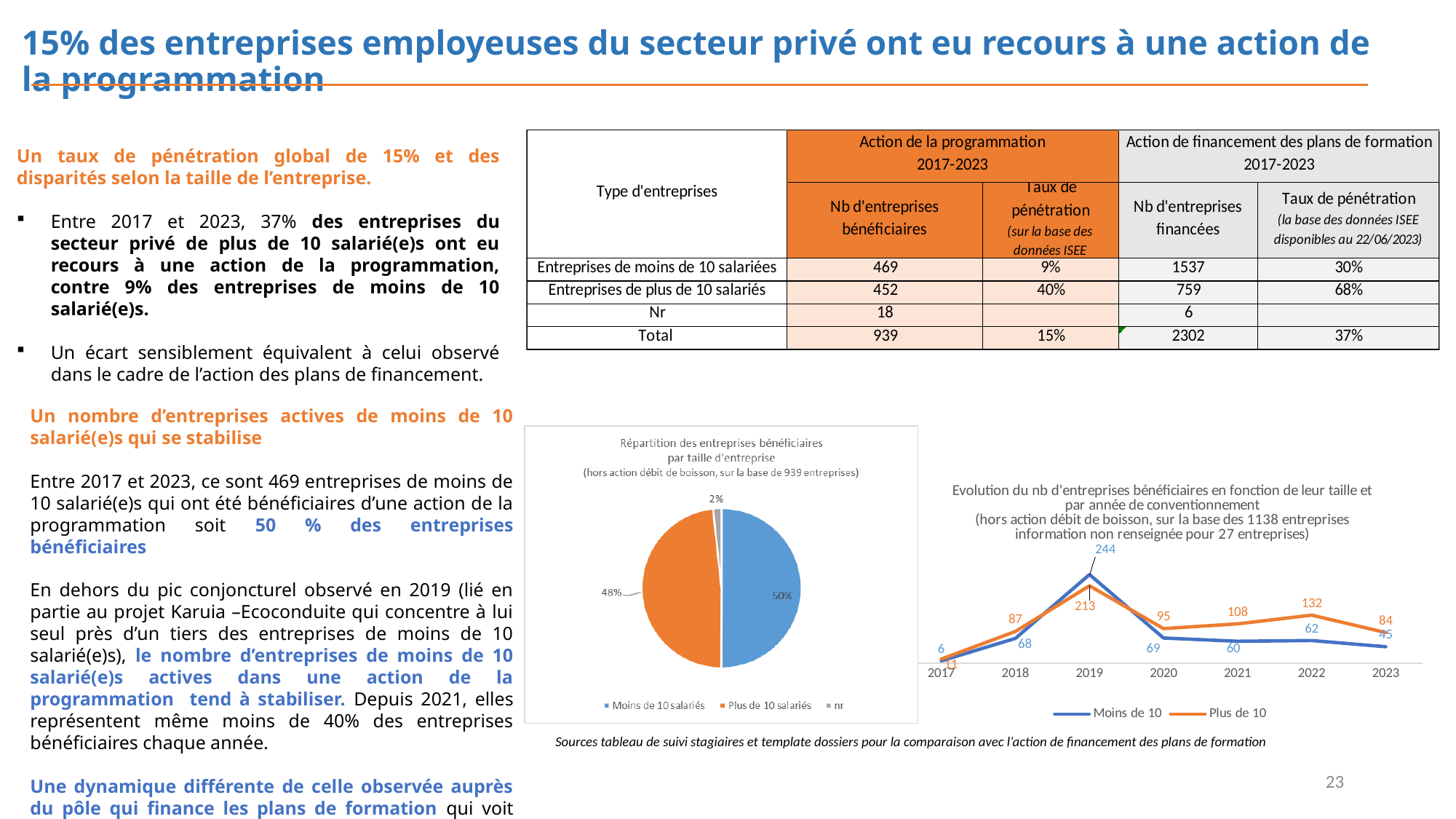
In the line chart 'Evolution du nb d'entreprises bénéficiaires', which series has the larger value in 2021? Plus de 10 In the line chart 'Evolution du nb d'entreprises bénéficiaires', does the 'Moins de 10' series rise or fall from 2019 to 2020? fall What type of chart is the chart on the right of the slide, 'Evolution du nb d'entreprises bénéficiaires'? line chart How many slices does the pie chart 'Répartition des entreprises bénéficiaires par taille d'entreprise' have? 3 How many series does the legend of the line chart 'Evolution du nb d'entreprises bénéficiaires' list? 2 In the pie chart 'Répartition des entreprises bénéficiaires par taille d'entreprise', what share is 'Moins de 10 salariés'? 50% In the line chart 'Evolution du nb d'entreprises bénéficiaires', what is the value for 'Plus de 10' in 2022? 132 In the line chart 'Evolution du nb d'entreprises bénéficiaires', what is the difference between 'Plus de 10' and 'Moins de 10' in 2023? 39 In the line chart 'Evolution du nb d'entreprises bénéficiaires', what is the value for 'Moins de 10' in 2019? 244 In the pie chart 'Répartition des entreprises bénéficiaires par taille d'entreprise', which slice is the smallest? nr In the line chart 'Evolution du nb d'entreprises bénéficiaires', in which year does 'Plus de 10' reach its highest value? 2019 In the pie chart 'Répartition des entreprises bénéficiaires par taille d'entreprise', what share is 'Plus de 10 salariés'? 48%